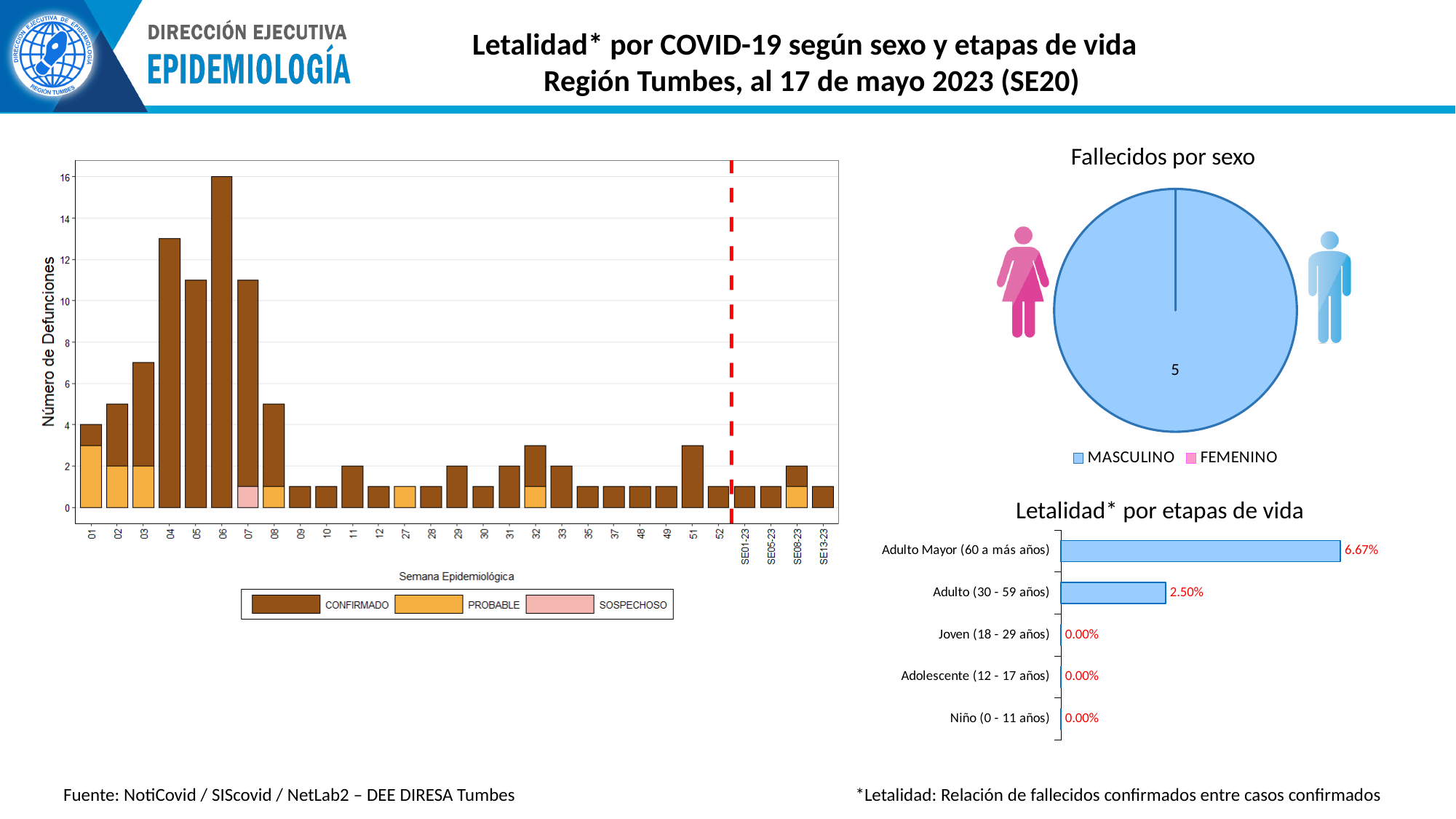
How many age-group categories are shown in the 'Letalidad* por etapas de vida' chart? 5 How many series does the legend of the bar chart of deaths by epidemiological week list? 3 In the 'Fallecidos por sexo' pie chart, what value is shown for MASCULINO? 5 How many series does the legend of the 'Fallecidos por sexo' pie chart list? 2 In the bar chart of deaths by epidemiological week on the left, what is the total number of deaths in week 06? 16 In the bar chart of deaths by epidemiological week on the left, is the total for week 04 greater or less than 12? greater In the 'Letalidad* por etapas de vida' chart, what is the difference between the values for Adulto Mayor (60 a más años) and Adulto (30 - 59 años)? 4.17% In the 'Letalidad* por etapas de vida' chart, what is the value for Joven (18 - 29 años)? 0.00% In the 'Letalidad* por etapas de vida' chart, which age group has the highest lethality? Adulto Mayor (60 a más años) In the bar chart of deaths by epidemiological week on the left, which week has the highest number of deaths? 06 In the 'Letalidad* por etapas de vida' chart, what is the value for Adulto Mayor (60 a más años)? 6.67% In the 'Letalidad* por etapas de vida' chart, what is the value for Adulto (30 - 59 años)? 2.50%